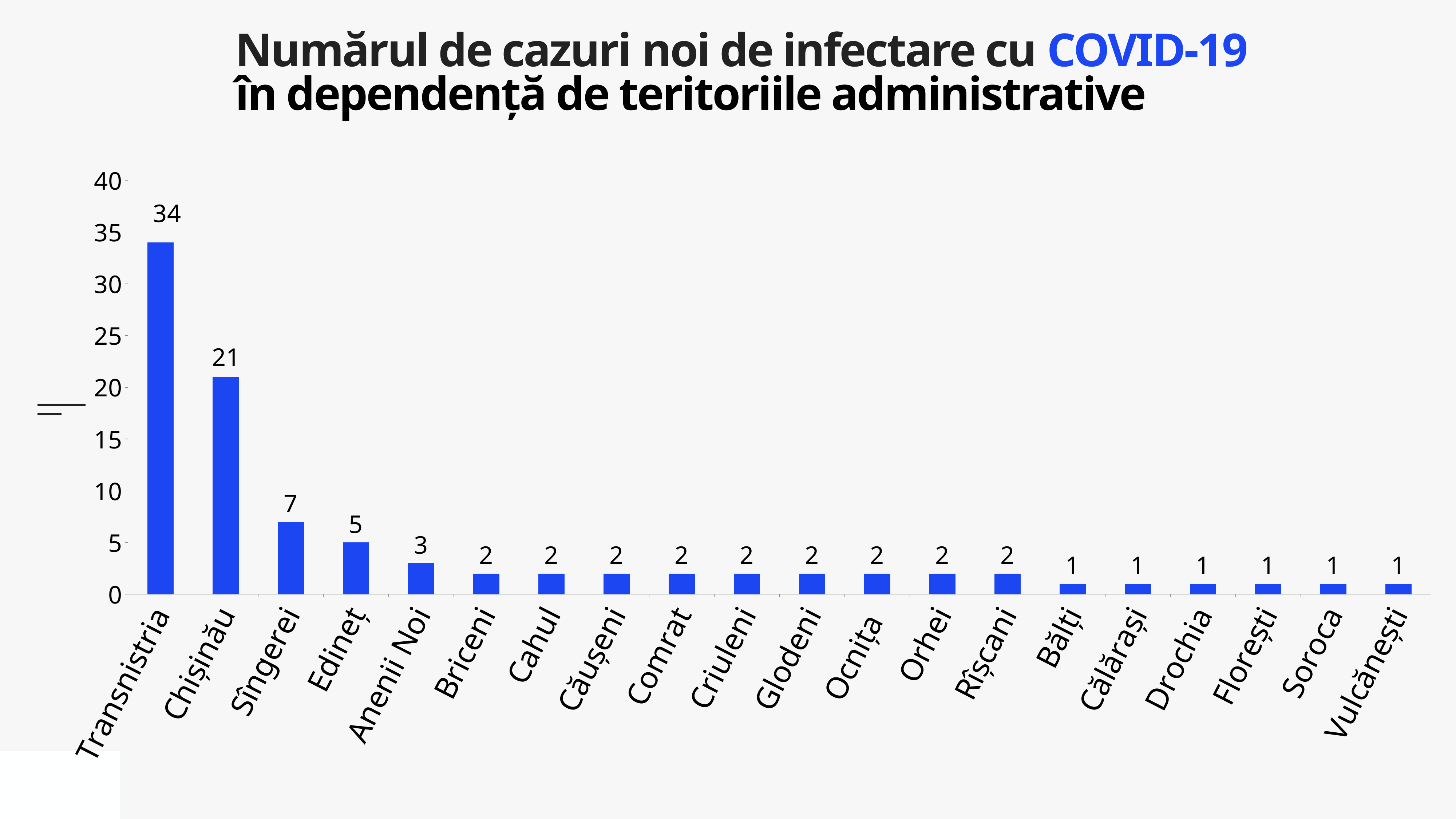
How many territories have a value of exactly 1? 6 What is the number of new COVID-19 cases for Chișinău? 21 What is the value shown for Anenii Noi? 3 Which administrative territory has the highest number of new cases? Transnistria What is the value shown for Sîngerei? 7 How many administrative territories are shown on the x axis? 20 What is the difference between the values for Sîngerei and Edineț? 2 What is the number of new COVID-19 cases for Transnistria? 34 What kind of chart is shown on the slide? Bar chart Which has a larger value, Edineț or Anenii Noi? Edineț What is the difference between the values for Transnistria and Chișinău? 13 Is the value for Chișinău greater or less than 20? greater